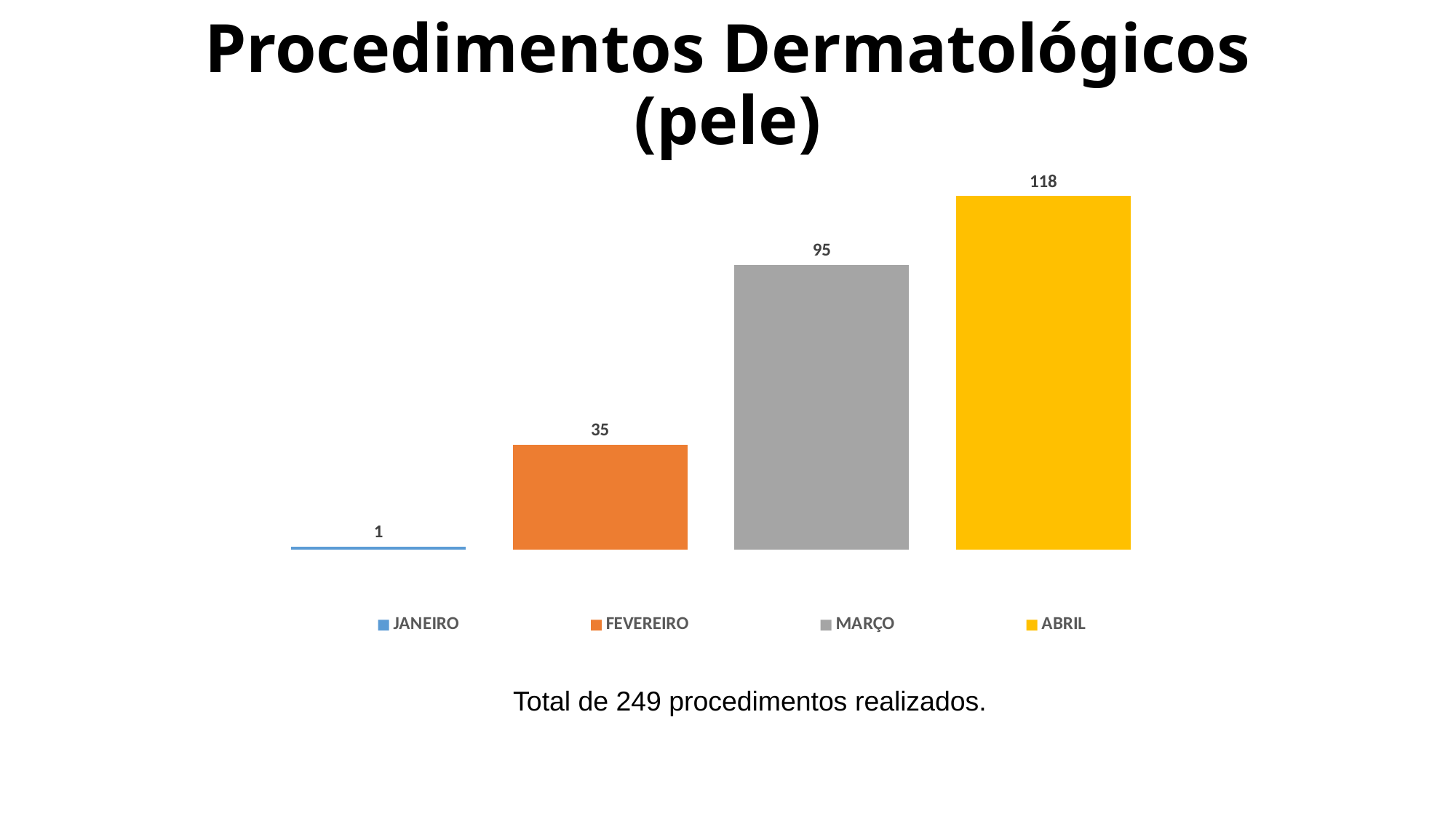
Do the values rise or fall from JANEIRO to ABRIL? rise Which month has the highest value? ABRIL What kind of chart is shown on the slide? bar chart What is the value for ABRIL? 118 Which is larger, the value for FEVEREIRO or the value for MARÇO? MARÇO What is the value for MARÇO? 95 What is the value for FEVEREIRO? 35 How many months are shown in the chart? 4 What is the value for JANEIRO? 1 What is the difference between the values for MARÇO and FEVEREIRO? 60 What is the difference between the values for ABRIL and MARÇO? 23 Which month has the lowest value? JANEIRO